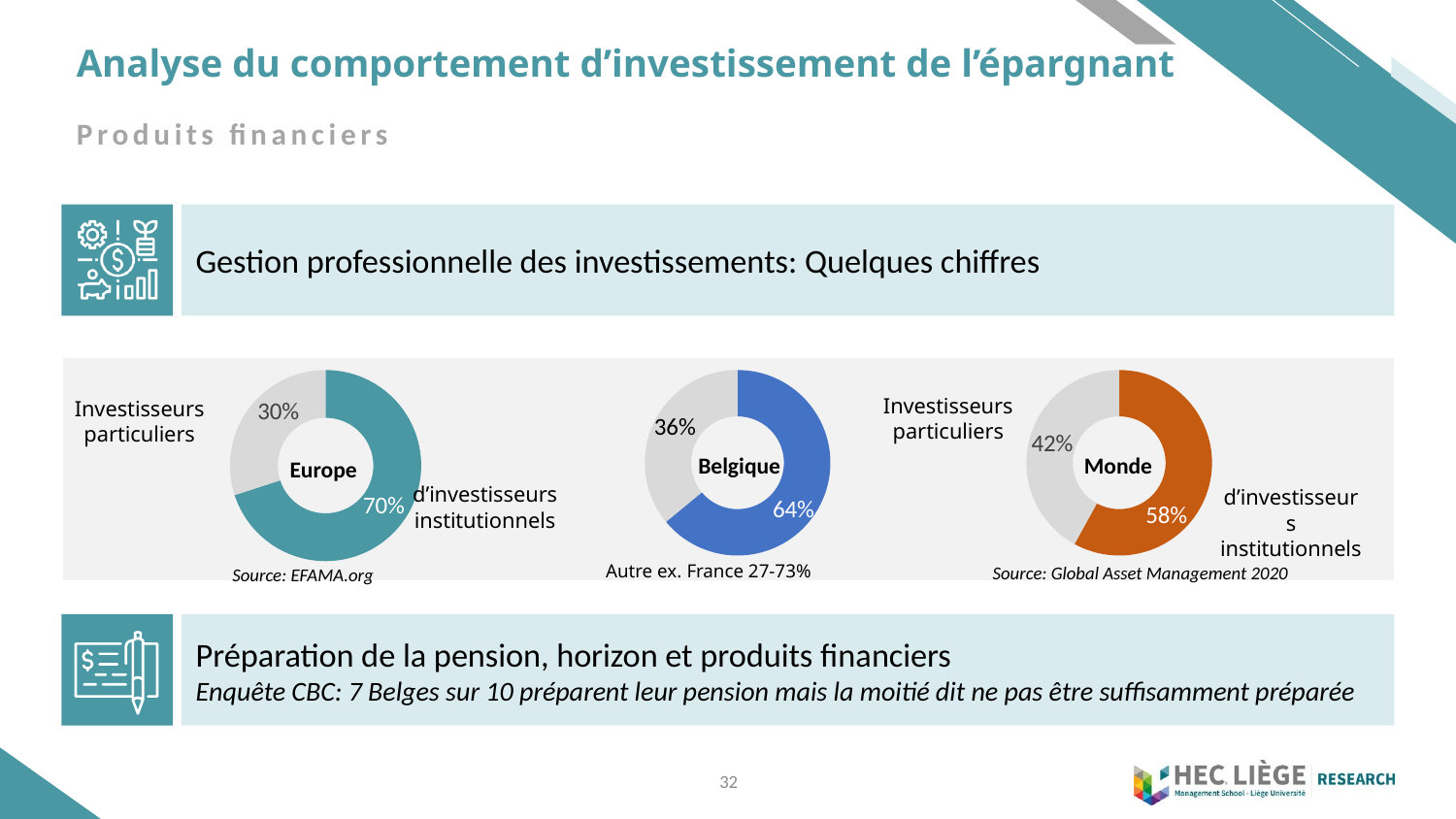
In the Europe chart, what is the difference between the institutional and individual investor shares? 40 percentage points In the Belgique chart, what is the value of the larger (blue) slice? 64% In the Monde chart, what is the difference between the institutional and individual investor shares? 16 percentage points In the Monde chart, what share is attributed to individual investors? 42% Which chart shows the highest share for individual investors: Europe, Belgique or Monde? Monde In the Europe chart, what share is attributed to individual investors (investisseurs particuliers)? 30% In the Europe chart, what share is attributed to institutional investors (investisseurs institutionnels)? 70% What type of chart is used for Europe, Belgique and Monde? Donut (pie) chart How many donut charts are shown on the slide? 3 In the Monde chart, what share is attributed to institutional investors? 58% Which chart shows the lowest share for individual investors: Europe, Belgique or Monde? Europe In the Belgique chart, what is the value of the smaller (grey) slice? 36%